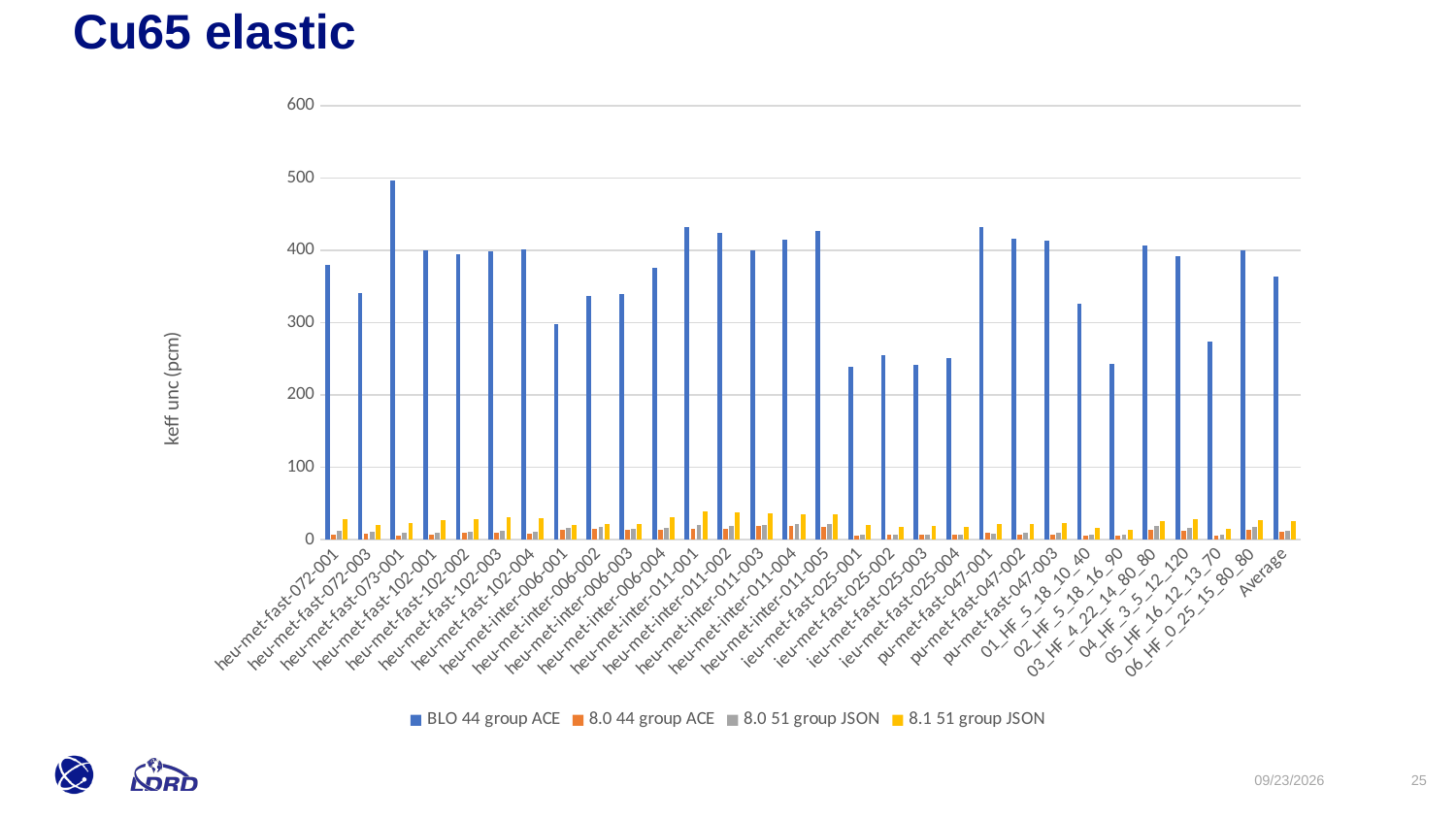
Is the BLO 44 group ACE value for heu-met-fast-073-001 greater or less than 400? greater Which has the larger BLO 44 group ACE value, heu-met-inter-006-001 or heu-met-inter-006-002? heu-met-inter-006-002 Is the BLO 44 group ACE value for ieu-met-fast-025-002 greater or less than 300? less What kind of chart is shown on the slide? bar chart Which has the larger BLO 44 group ACE value, heu-met-fast-072-001 or heu-met-fast-072-003? heu-met-fast-072-001 How many categories are shown along the x axis? 30 How many series does the legend list? 4 Is the BLO 44 group ACE value for 05_HF_16_12_13_70 greater or less than 300? less What is the title of the slide containing the chart? Cu65 elastic Which category has the highest BLO 44 group ACE value? heu-met-fast-073-001 What is the label on the y axis of the chart? keff unc (pcm)